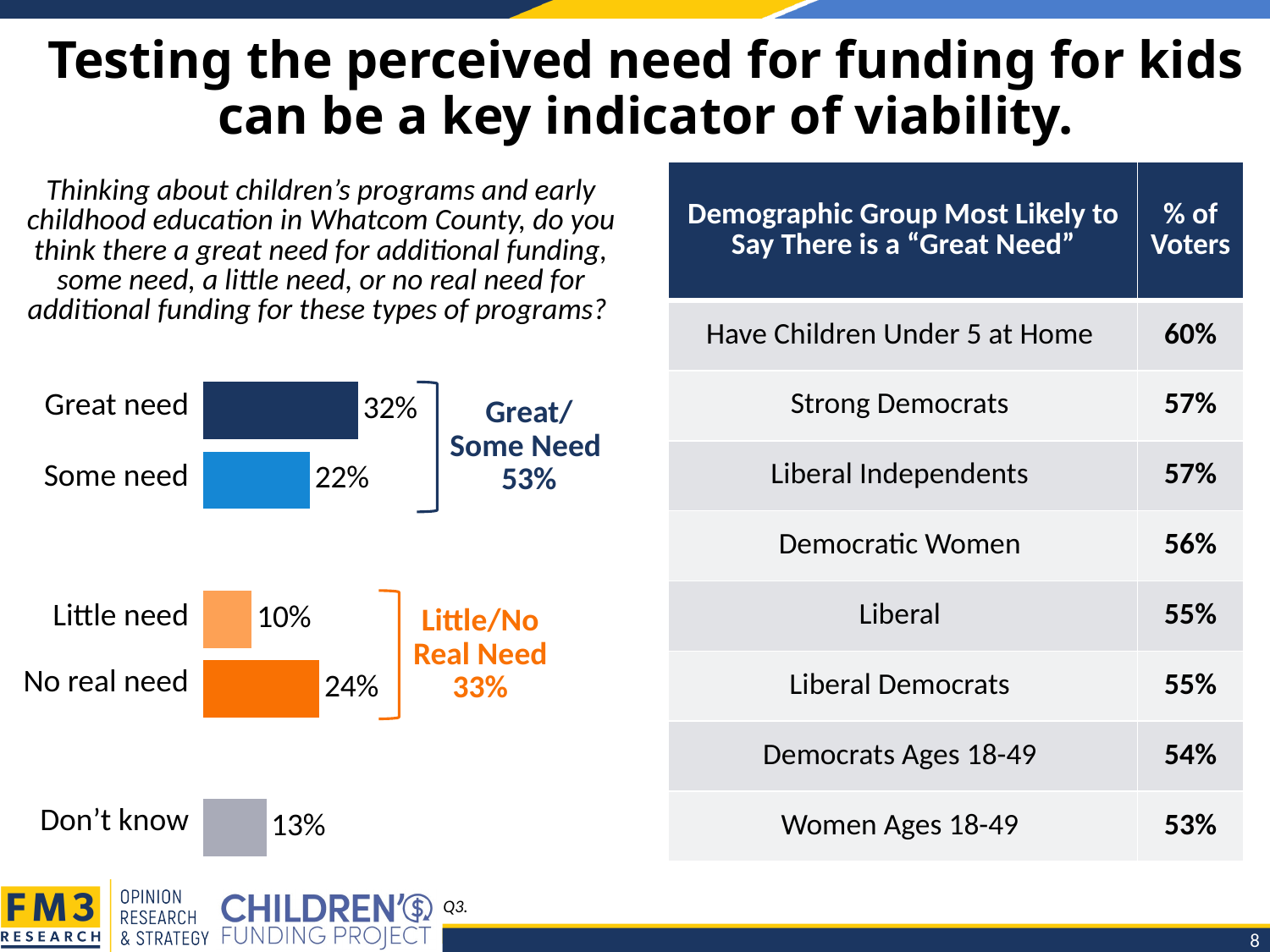
What percentage of respondents answered 'Don't know'? 13% What colour is the bar for 'Don't know'? Gray What is the difference in percentage points between 'Great need' and 'Some need'? 10 Which is larger, the percentage for 'No real need' or the percentage for 'Some need'? No real need What combined percentage is shown for 'Little/No Real Need'? 33% Which response category has the highest percentage in the bar chart? Great need What combined percentage is shown for 'Great/Some Need'? 53% What percentage of respondents said there is a great need for additional funding? 32% How many response categories are shown in the bar chart? 5 What kind of chart is used to show the responses to the funding need question? Bar chart Which response category has the lowest percentage in the bar chart? Little need What percentage of respondents said there is no real need for additional funding? 24%